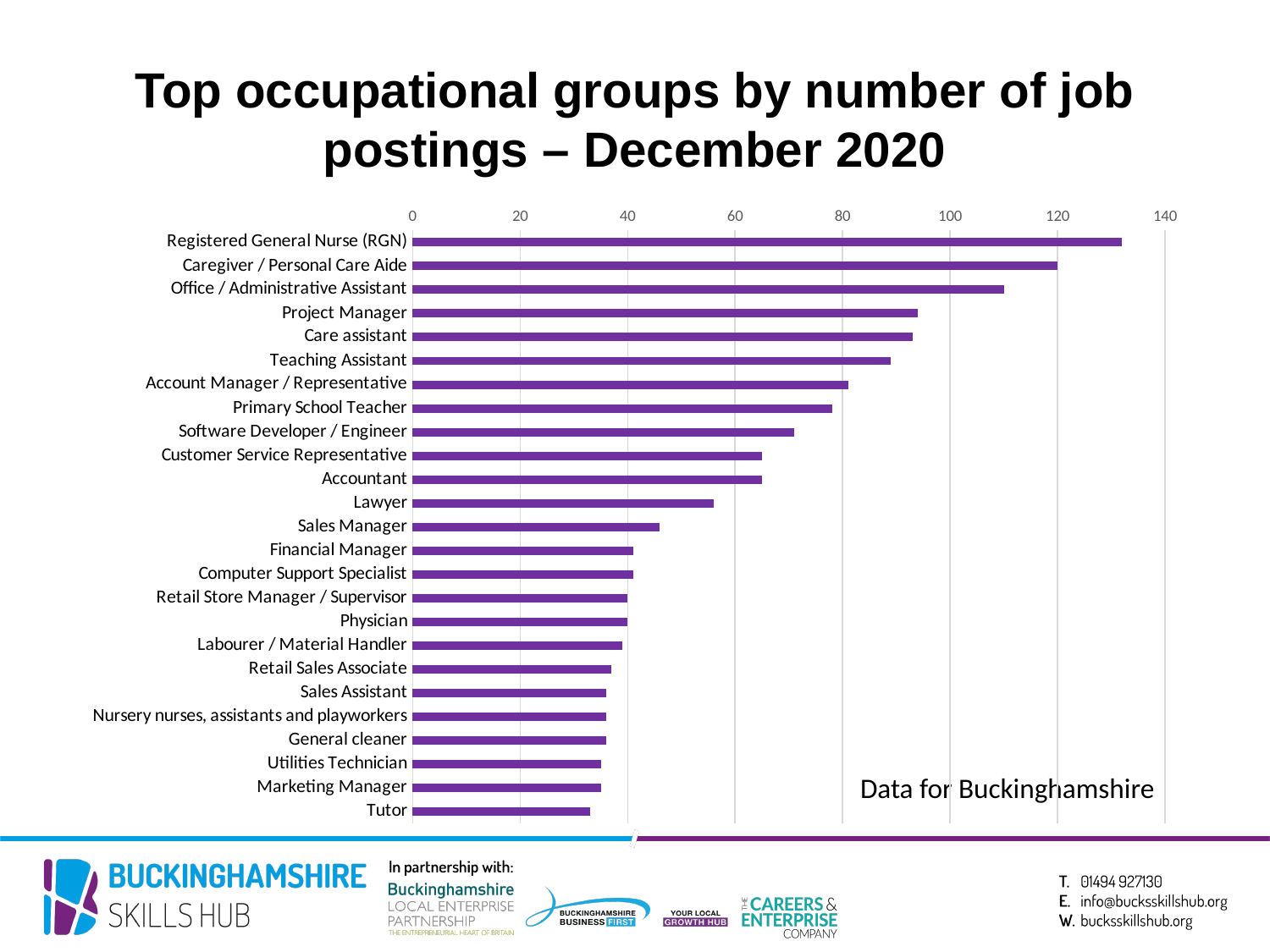
How many occupational groups are shown in the chart? 25 Is the value for Registered General Nurse (RGN) greater or less than 120? greater Is the value for Tutor greater or less than 40? less Which has more job postings, Registered General Nurse (RGN) or Caregiver / Personal Care Aide? Registered General Nurse (RGN) Is the value for Lawyer greater or less than 40? greater Which occupational group has the lowest number of job postings? Tutor What kind of chart is shown on the slide? Bar chart Which has more job postings, Lawyer or Sales Manager? Lawyer Which area does the chart state the data is for? Buckinghamshire Which occupational group has the highest number of job postings? Registered General Nurse (RGN)